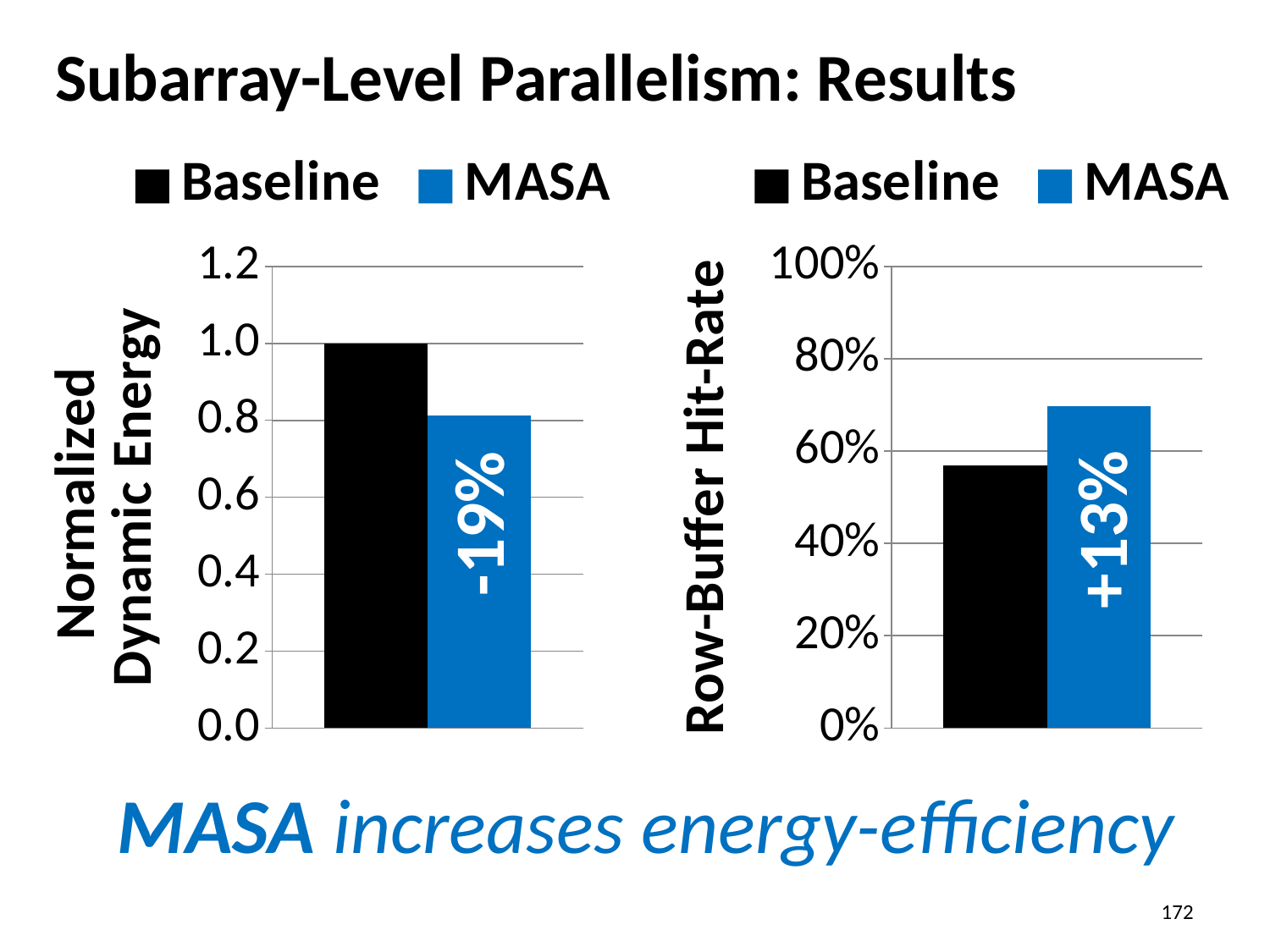
In the Row-Buffer Hit-Rate chart, is the value for MASA greater or less than 80%? less In the Row-Buffer Hit-Rate chart, which series has the higher value, Baseline or MASA? MASA In the Normalized Dynamic Energy chart, what is the value for Baseline? 1.0 What kind of chart is the Normalized Dynamic Energy chart? bar chart In the Normalized Dynamic Energy chart, what percentage change is printed on the MASA bar? -19% In the Normalized Dynamic Energy chart, which series has the lower value, Baseline or MASA? MASA In the Normalized Dynamic Energy chart, is the value for MASA greater or less than 0.6? greater In the Row-Buffer Hit-Rate chart, is the value for MASA greater or less than 60%? greater In the Row-Buffer Hit-Rate chart, what colour is the MASA bar? blue How many series does the legend of the Row-Buffer Hit-Rate chart list? 2